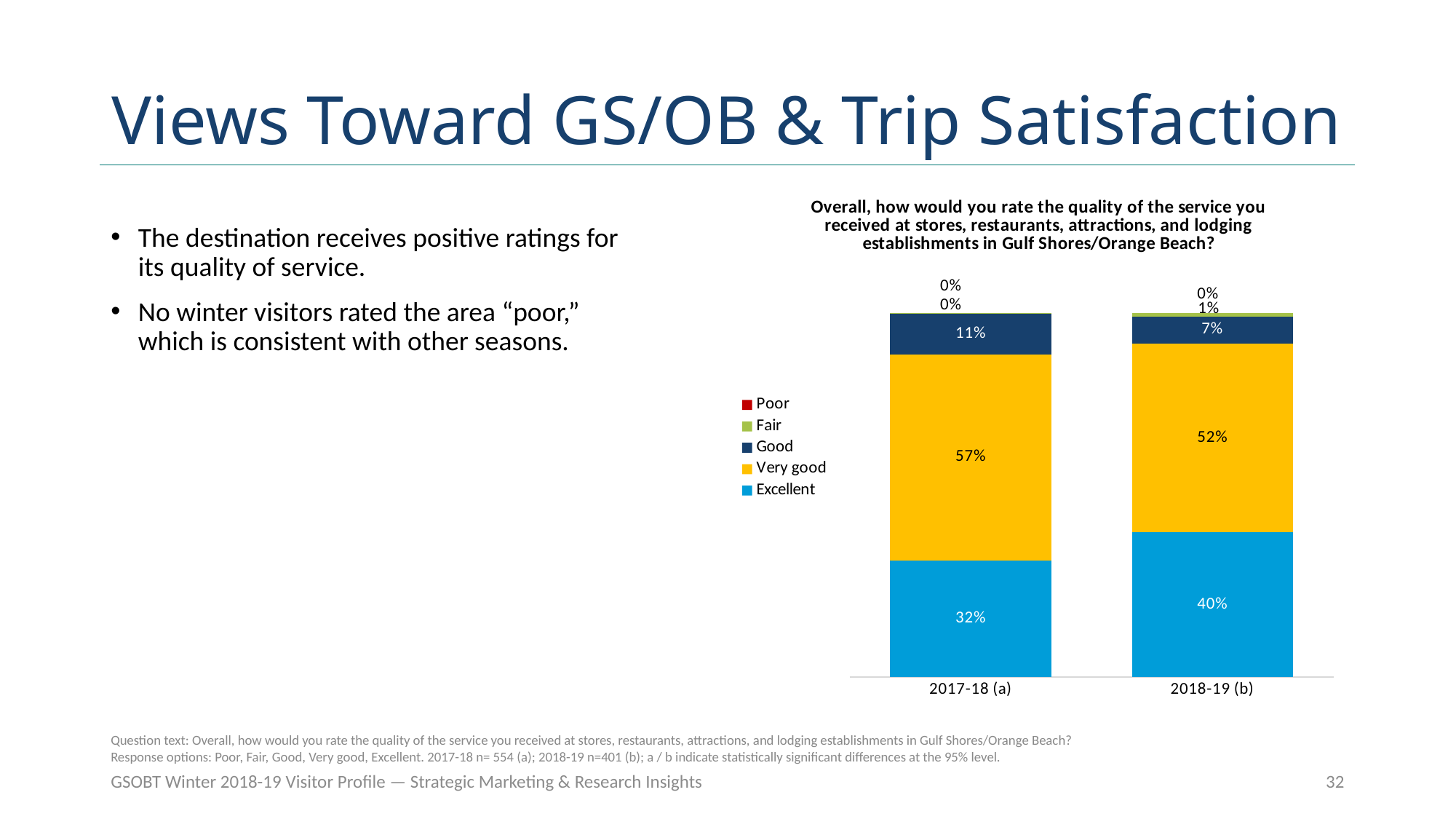
What is the "Good" value for 2018-19 (b)? 7% What percentage of 2018-19 (b) visitors rated the quality of service as "Excellent"? 40% What percentage of 2017-18 (a) visitors rated the quality of service as "Very good"? 57% Which year has the larger "Very good" share, 2017-18 (a) or 2018-19 (b)? 2017-18 (a) What is the "Fair" value for 2018-19 (b)? 1% What is the "Excellent" value for 2017-18 (a)? 32% What type of chart is shown on the slide? Stacked bar chart Which rating category has the largest share in the 2018-19 (b) bar? Very good How many series does the legend list? 5 By how many percentage points did the "Excellent" share change from 2017-18 (a) to 2018-19 (b)? 8 percentage points What is the difference between the "Good" values for 2017-18 (a) and 2018-19 (b)? 4 percentage points Which colour represents "Excellent" in the chart? Light blue